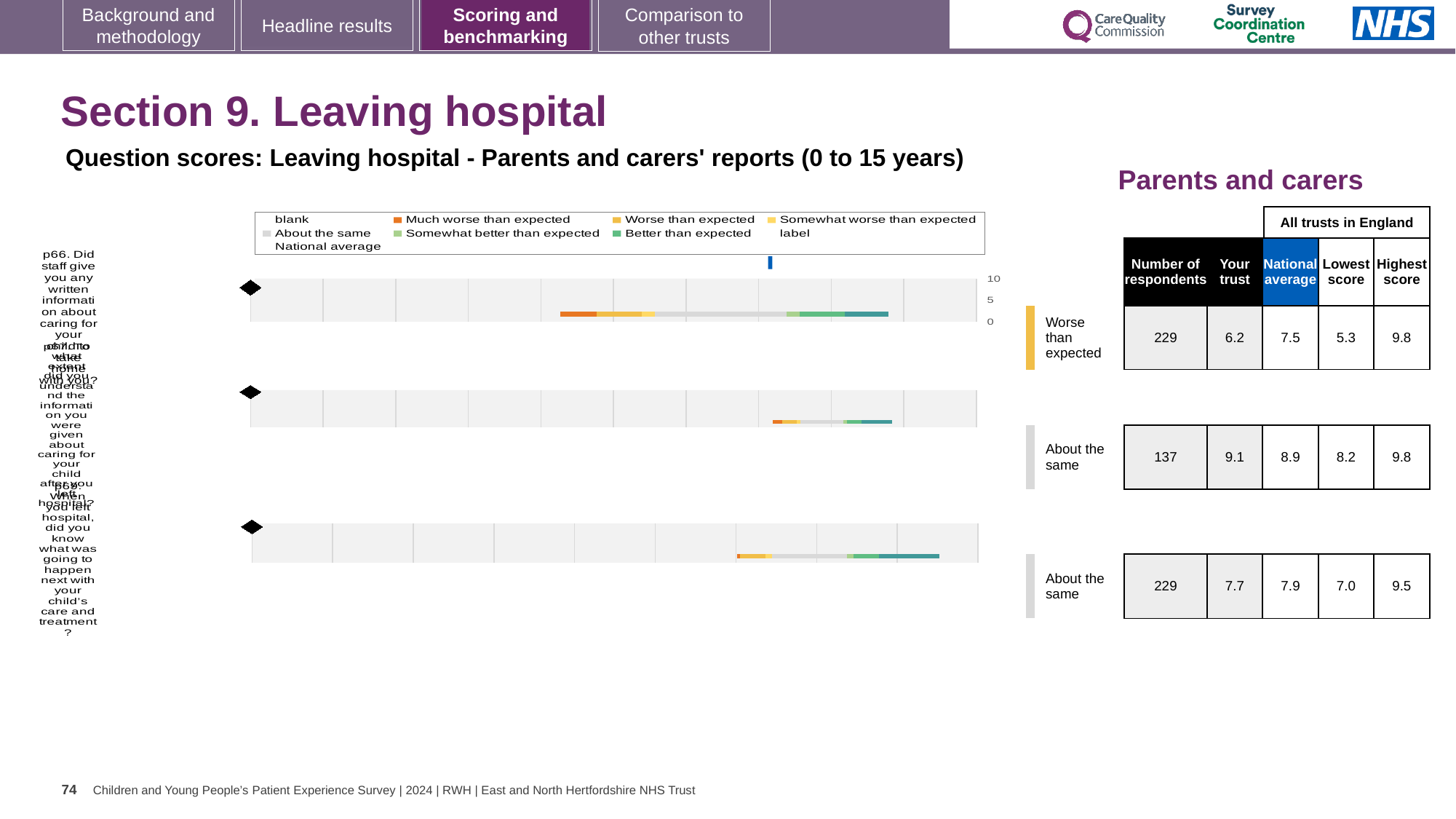
For the top chart (p66), what is the national average score shown in the adjacent table? 7.5 Which of the three charts has the highest 'Your trust' score? the middle chart (9.1) For the middle chart, how many respondents are shown in the adjacent table? 137 What kind of chart is used for the question rows on this slide? bar chart For the top chart (p66), what is the 'Your trust' score shown in the adjacent table? 6.2 How many entries does the chart legend list? 9 For the middle chart, what is the difference between the 'Your trust' score (9.1) and the national average (8.9)? 0.2 How many question rows (bar charts) are shown on the slide? 3 For the bottom chart, which is larger: the 'Your trust' score or the national average? National average What is the highest tick shown on the chart's value axis? 10 What colour does the legend use for 'Much worse than expected'? orange For the top chart (p66), what benchmark category is shown next to the chart? Worse than expected